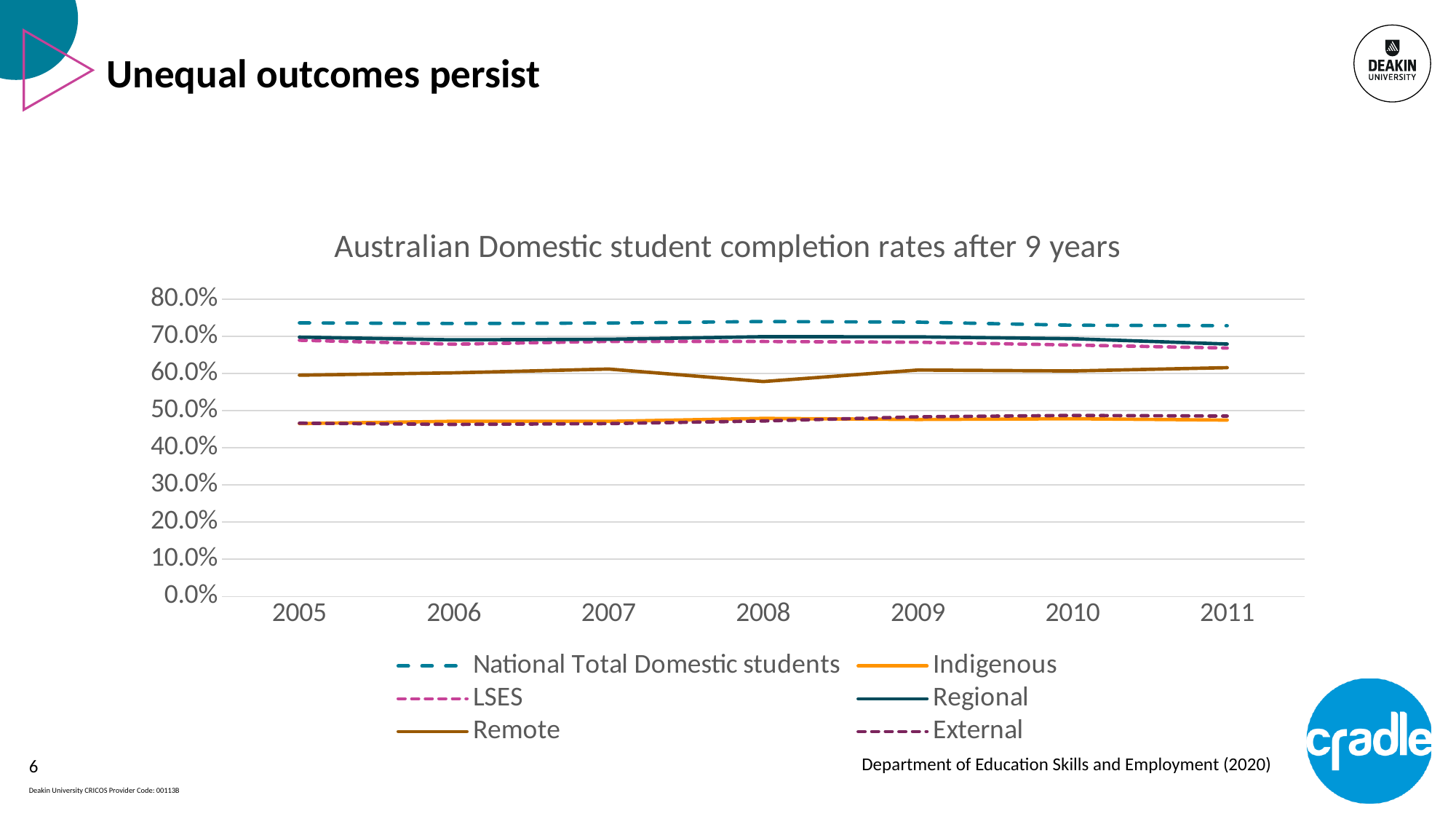
Is the value for National Total Domestic students in 2005 greater or less than 70.0%? greater How many years are shown on the x axis? 7 Does the LSES series rise or fall from 2005 to 2011? fall Is the value for Remote in 2008 greater or less than 60.0%? less Which is larger in 2008, the Remote value or the Indigenous value? Remote Which series has the highest completion rate across all years? National Total Domestic students How many series does the legend list? 6 What source is cited below the chart? Department of Education Skills and Employment (2020) What kind of chart is shown on the slide? line chart What is the title of the chart? Australian Domestic student completion rates after 9 years In which year is the Remote series at its lowest? 2008 Is the value for Indigenous in 2005 greater or less than 50.0%? less